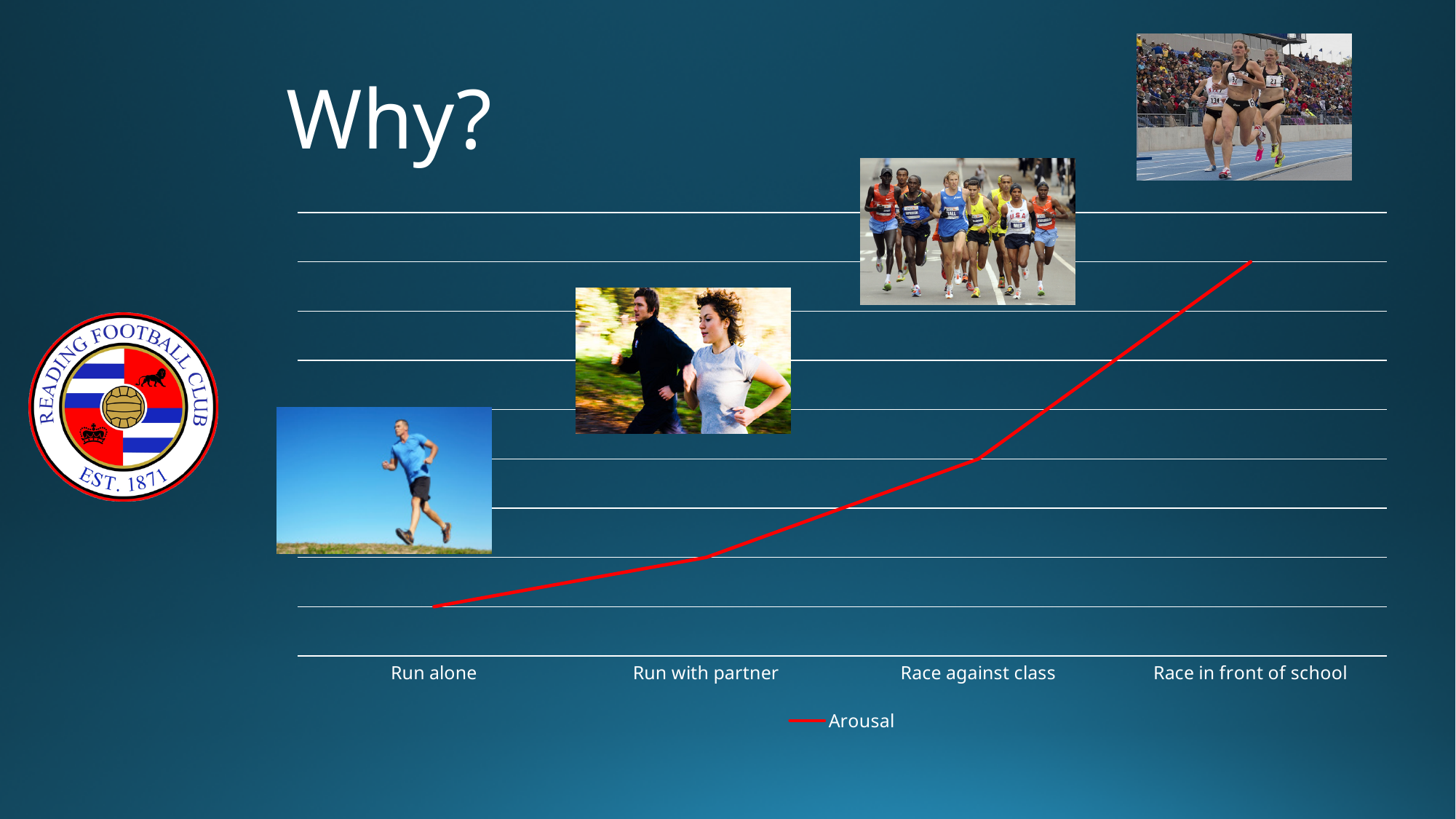
Which has the higher Arousal value, Run with partner or Race against class? Race against class Which category has the highest Arousal value? Race in front of school Which category has the lowest Arousal value? Run alone What is the label of the third category on the x axis? Race against class Which has the lower Arousal value, Run alone or Race in front of school? Run alone What kind of chart is shown on the slide? Line chart Do the Arousal values rise or fall from Run alone to Race in front of school? Rise What colour is the Arousal line in the chart? Red What is the name of the series shown in the chart's legend? Arousal How many series does the chart's legend list? 1 How many categories are shown along the x axis of the chart? 4